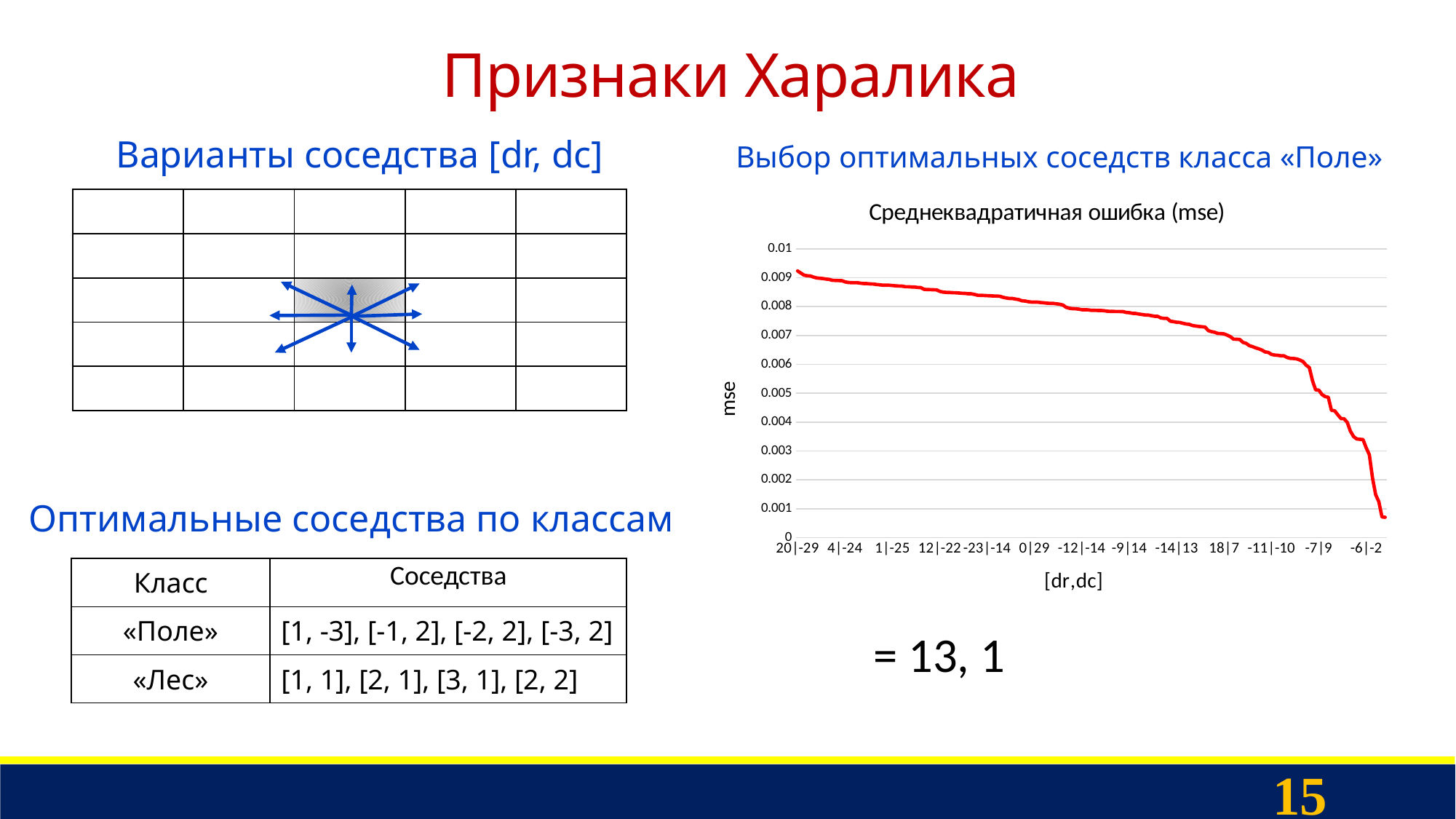
Is the mse value at -11|-10 greater or less than 0.006? greater What is the label of the y axis of the chart? mse Is the mse value at 12|-22 greater or less than 0.008? greater What is the title of the chart? Среднеквадратичная ошибка (mse) Do the mse values rise or fall moving from left to right along the x axis? fall How many tick labels are shown on the x axis of the chart? 13 Which has the larger mse value, 20|-29 or -6|-2? 20|-29 Is the mse value at the right end of the line greater or less than 0.002? less What kind of chart is shown under the heading "Среднеквадратичная ошибка (mse)"? line chart Which x-axis category has the highest mse value? 20|-29